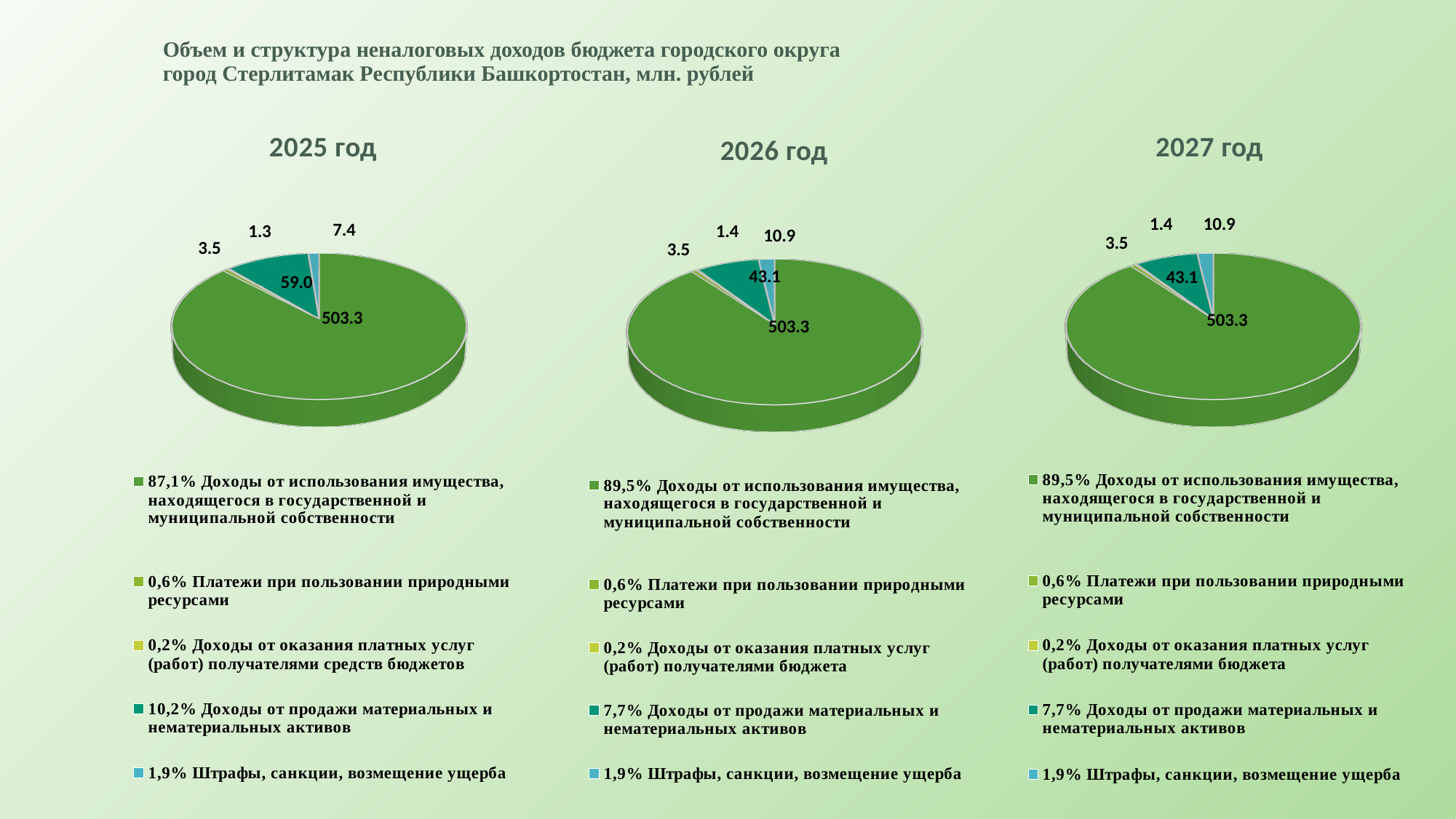
In the 2025 год chart, what share of the pie is Доходы от продажи материальных и нематериальных активов? 10,2% In the 2025 год chart, which is larger: Штрафы, санкции, возмещение ущерба or Платежи при пользовании природными ресурсами? Штрафы, санкции, возмещение ущерба In the 2027 год chart, what is the value for Доходы от использования имущества, находящегося в государственной и муниципальной собственности? 503.3 In the 2025 год chart, what is the value for Доходы от продажи материальных и нематериальных активов? 59.0 In the 2026 год chart, which category has the smallest slice? Доходы от оказания платных услуг (работ) получателями бюджета How many slices does the 2027 год pie chart have? 5 In the 2025 год chart, which category has the largest slice? Доходы от использования имущества, находящегося в государственной и муниципальной собственности What is the difference between the value for Доходы от продажи материальных и нематериальных активов in the 2025 год chart and in the 2026 год chart? 15.9 In the 2027 год chart, what share of the pie is Доходы от использования имущества, находящегося в государственной и муниципальной собственности? 89,5% In the 2026 год chart, what is the value for Штрафы, санкции, возмещение ущерба? 10.9 What type of charts are shown on the slide? Pie charts How many entries does the legend of the 2026 год chart list? 5